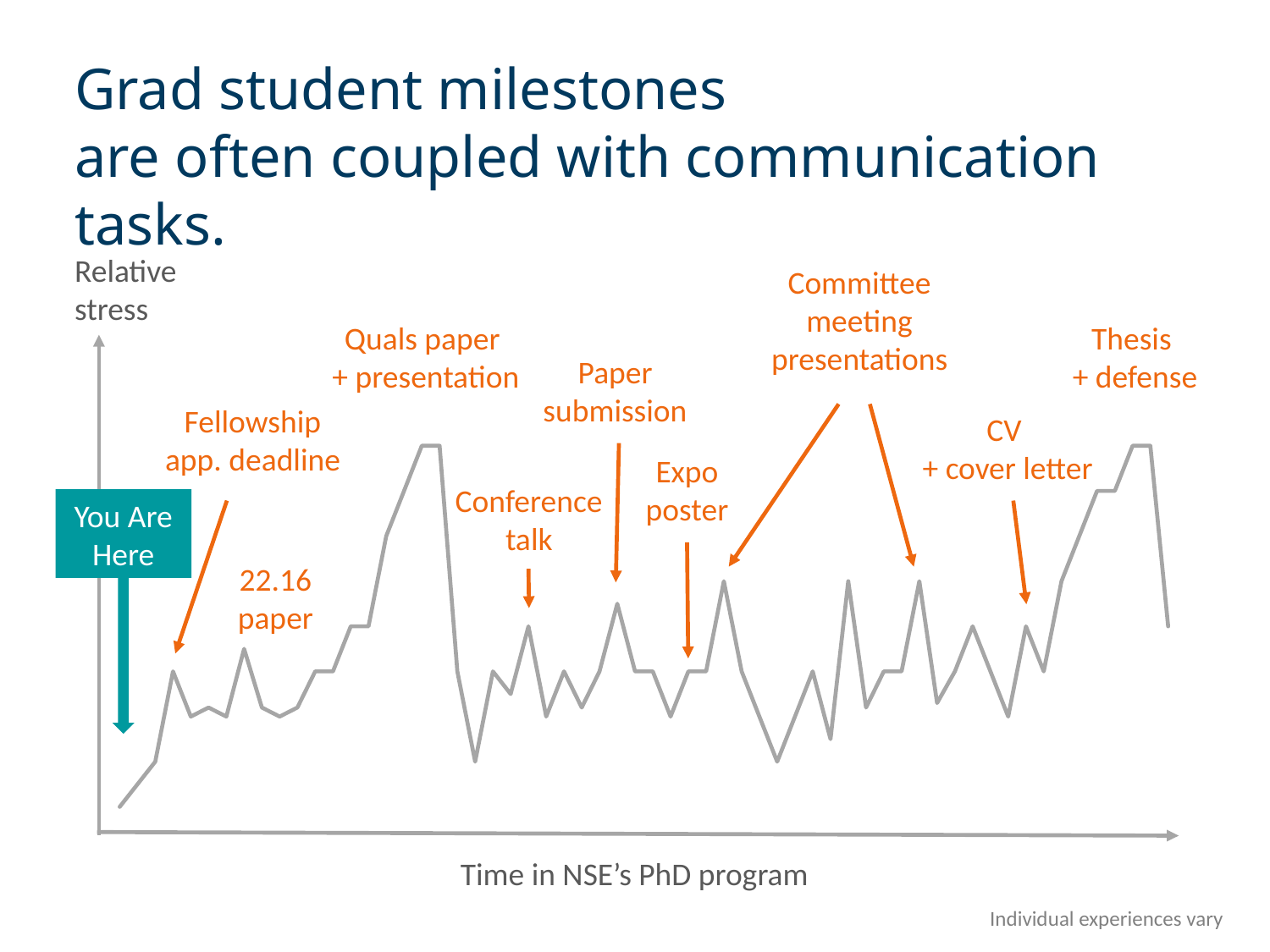
Which shows a higher relative stress peak, the Committee meeting presentations or the Expo poster? Committee meeting presentations Which milestone shows a higher relative stress peak, Paper submission or Expo poster? Paper submission How many labeled milestones are annotated on the stress line? 9 What is the label on the x axis of the chart? Time in NSE's PhD program What kind of chart is shown on the slide? Line chart Which milestone shows a higher relative stress peak, Fellowship app. deadline or Quals paper + presentation? Quals paper + presentation What is the label on the y axis of the chart? Relative stress Does the relative stress line rise or fall between the CV + cover letter milestone and the Thesis + defense peak? Rise Does the relative stress line rise or fall from the start of the x axis up to the Fellowship app. deadline? Rise Does the relative stress line rise or fall immediately after the Quals paper + presentation peak? Fall